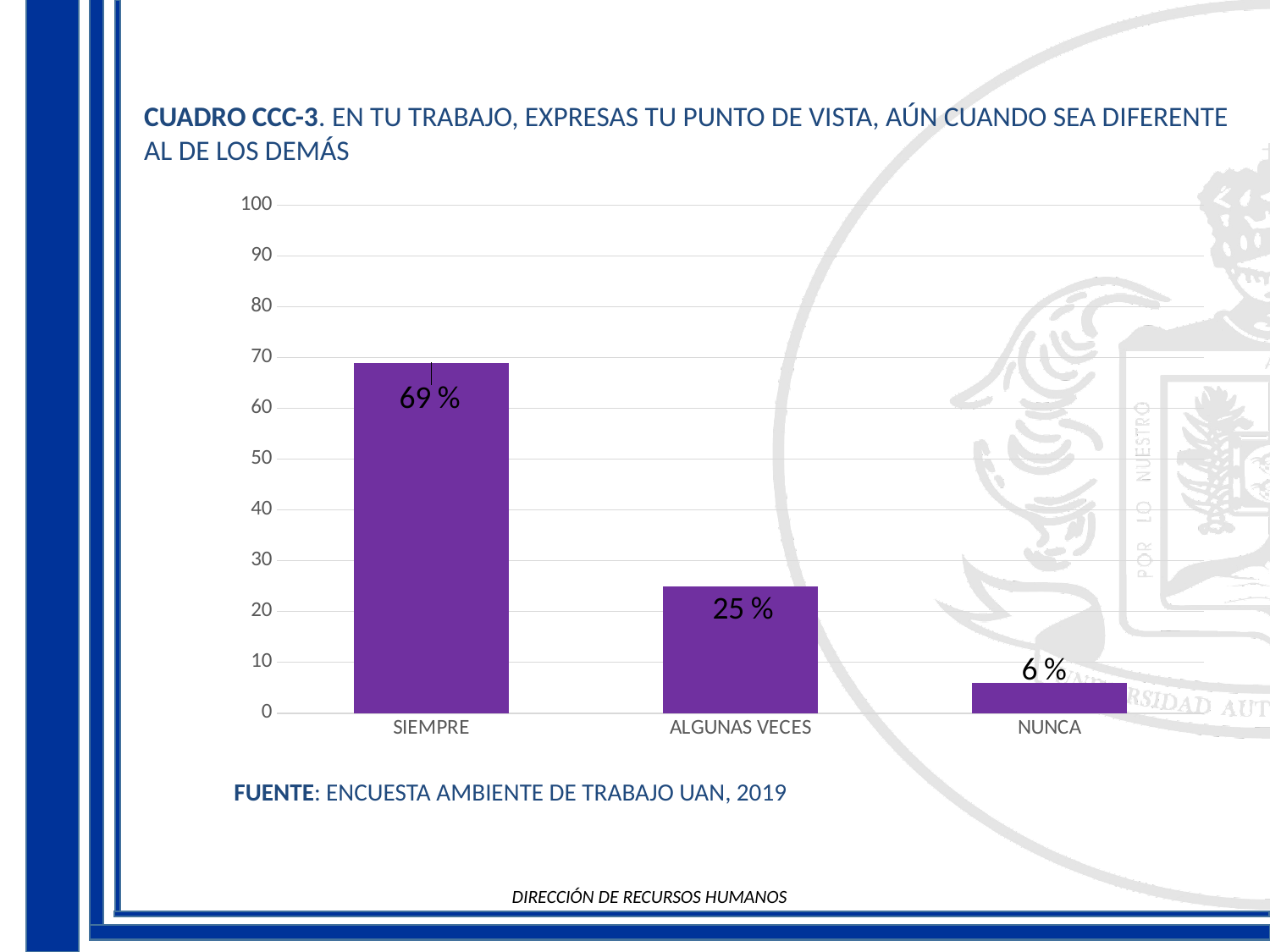
Which is larger, the value for ALGUNAS VECES or the value for NUNCA? ALGUNAS VECES Which category has the highest value? SIEMPRE What is the value for NUNCA? 6 % What kind of chart is shown on the slide? bar chart What colour are the bars in the chart? purple What is the value for ALGUNAS VECES? 25 % What is the value for SIEMPRE? 69 % Which category has the lowest value? NUNCA What is the difference between the values for SIEMPRE and ALGUNAS VECES? 44 % What is the difference between the values for ALGUNAS VECES and NUNCA? 19 % How many categories are shown on the x axis? 3 Is the value for SIEMPRE greater or less than 60? greater